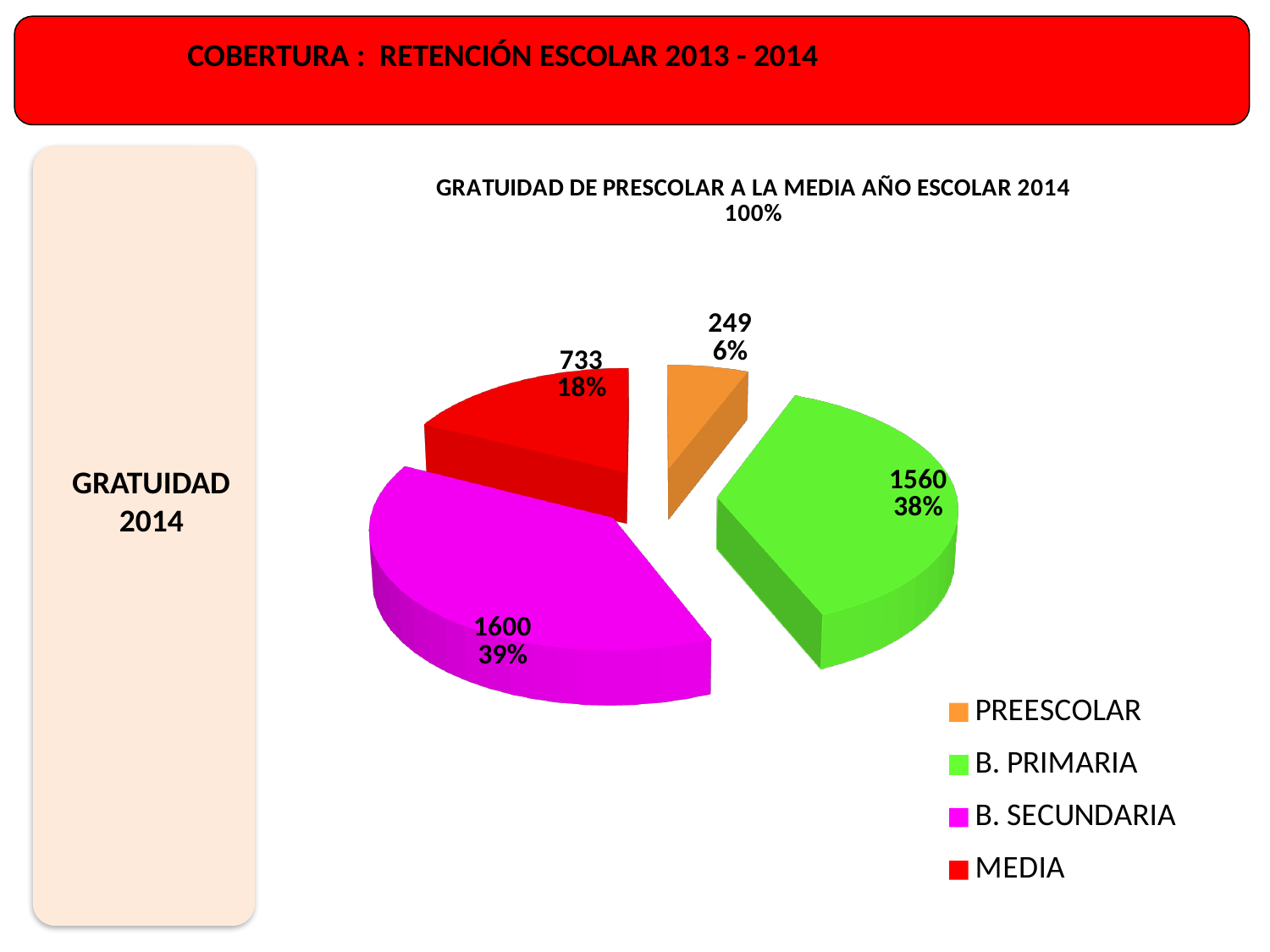
What is the difference between the values for B. SECUNDARIA and B. PRIMARIA? 40 What is the title of the chart? GRATUIDAD DE PRESCOLAR A LA MEDIA AÑO ESCOLAR 2014 100% Which category has the smallest slice of the pie? PREESCOLAR What percentage share is shown for MEDIA? 18% What value is shown for B. PRIMARIA? 1560 What is the difference between the values for MEDIA and PREESCOLAR? 484 How many categories does the pie chart show? 4 Which is larger, the value for MEDIA or the value for PREESCOLAR? MEDIA What percentage share is shown for B. SECUNDARIA? 39% What kind of chart is shown on the slide? Pie chart What value is shown for PREESCOLAR? 249 Which category has the largest slice of the pie? B. SECUNDARIA